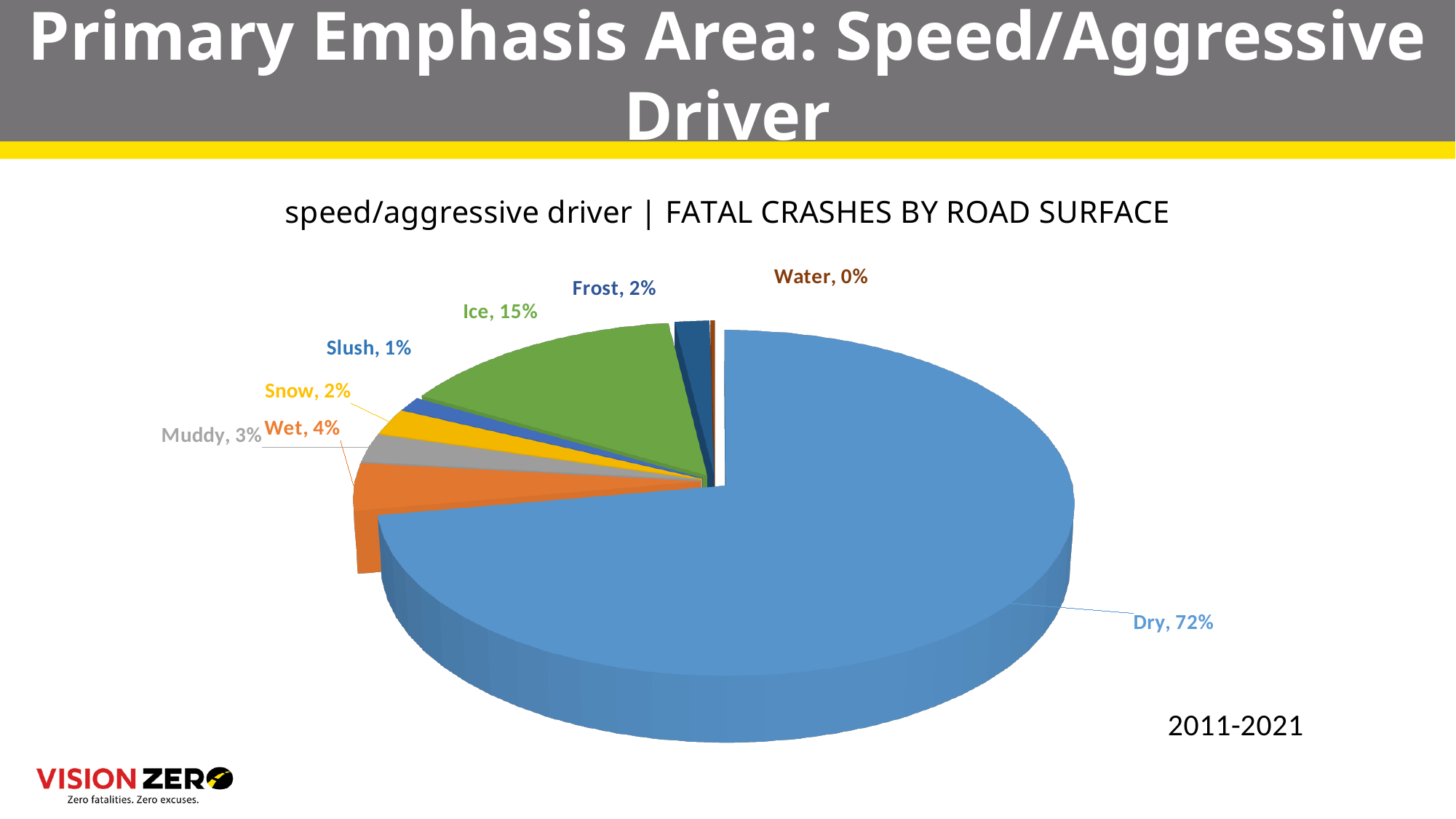
What share of fatal crashes occurred on a slush road surface? 1% What time period does the chart cover? 2011-2021 What share of fatal crashes occurred on an icy road surface? 15% Which road surface category has the smallest share of fatal crashes? Water How many road surface categories are shown in the pie chart? 8 What is the difference in percentage points between the Dry and Ice shares? 57 What share of fatal crashes occurred on a muddy road surface? 3% Which road surface category has the largest share of fatal crashes? Dry What kind of chart is shown on the slide? Pie chart Which has a larger share of fatal crashes, Wet or Muddy? Wet What share of fatal crashes occurred on a dry road surface? 72% What share of fatal crashes occurred on a wet road surface? 4%